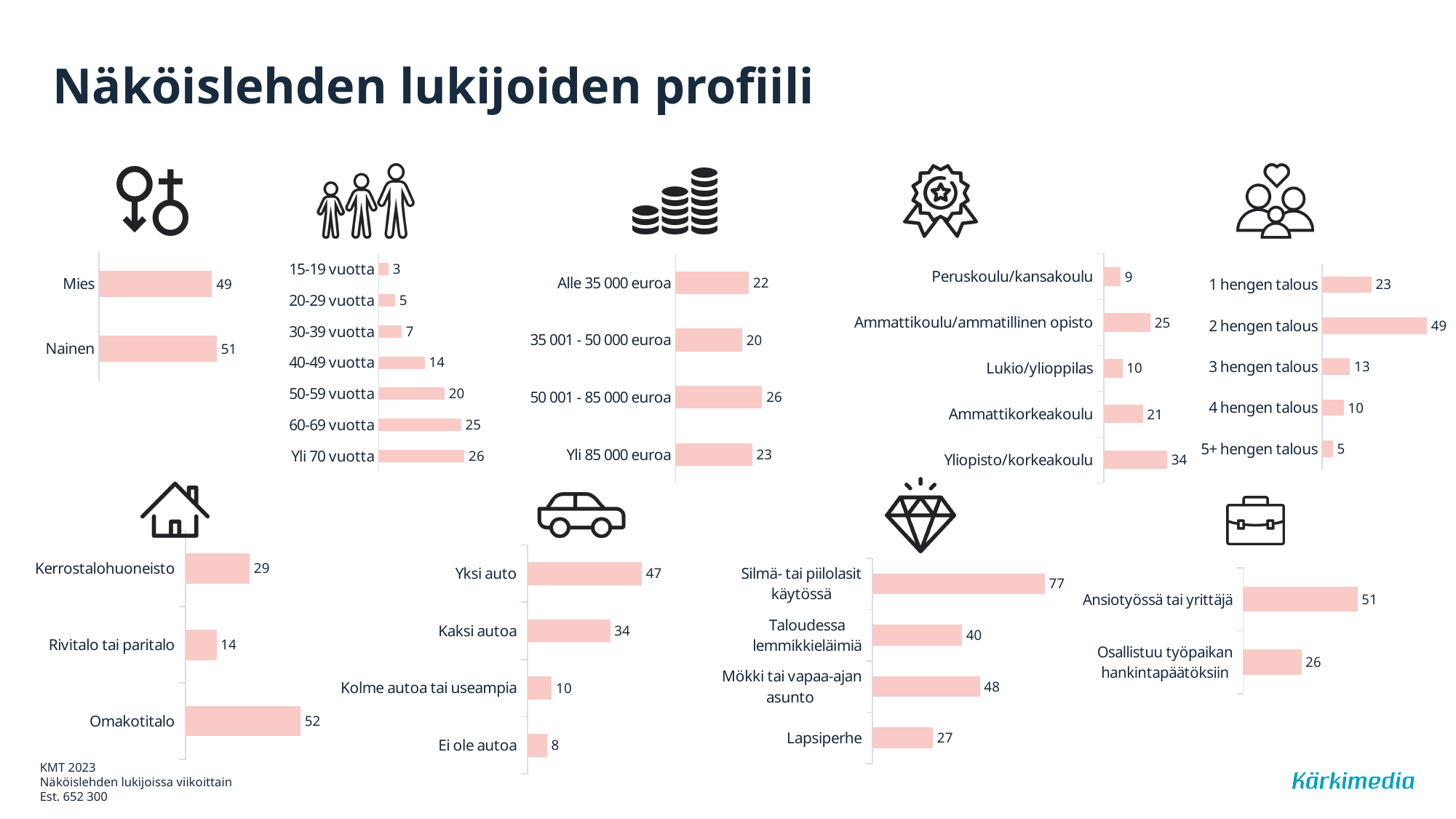
In the car ownership chart, which is larger: Yksi auto or Kaksi autoa? Yksi auto In the age chart (15-19 vuotta to Yli 70 vuotta), which age group has the highest value? Yli 70 vuotta In the household size chart (1 hengen talous to 5+ hengen talous), which category has the highest value? 2 hengen talous In the chart with the diamond icon, what is the value for Silmä- tai piilolasit käytössä? 77 In the age chart (15-19 vuotta to Yli 70 vuotta), which age group has the lowest value? 15-19 vuotta In the housing type chart at the bottom left (Kerrostalohuoneisto, Rivitalo tai paritalo, Omakotitalo), what is the value for Omakotitalo? 52 What type of chart is used for the gender chart at the top left (Mies/Nainen)? Bar chart In the income chart (Alle 35 000 euroa to Yli 85 000 euroa), what is the value for 50 001 - 85 000 euroa? 26 In the education chart, what is the difference between Yliopisto/korkeakoulu and Peruskoulu/kansakoulu? 25 In the gender chart at the top left (Mies/Nainen), what is the value for Nainen? 51 In the age chart, how many age categories are shown? 7 In the chart with the briefcase icon at the bottom right, what is the difference between Ansiotyössä tai yrittäjä and Osallistuu työpaikan hankintapäätöksiin? 25